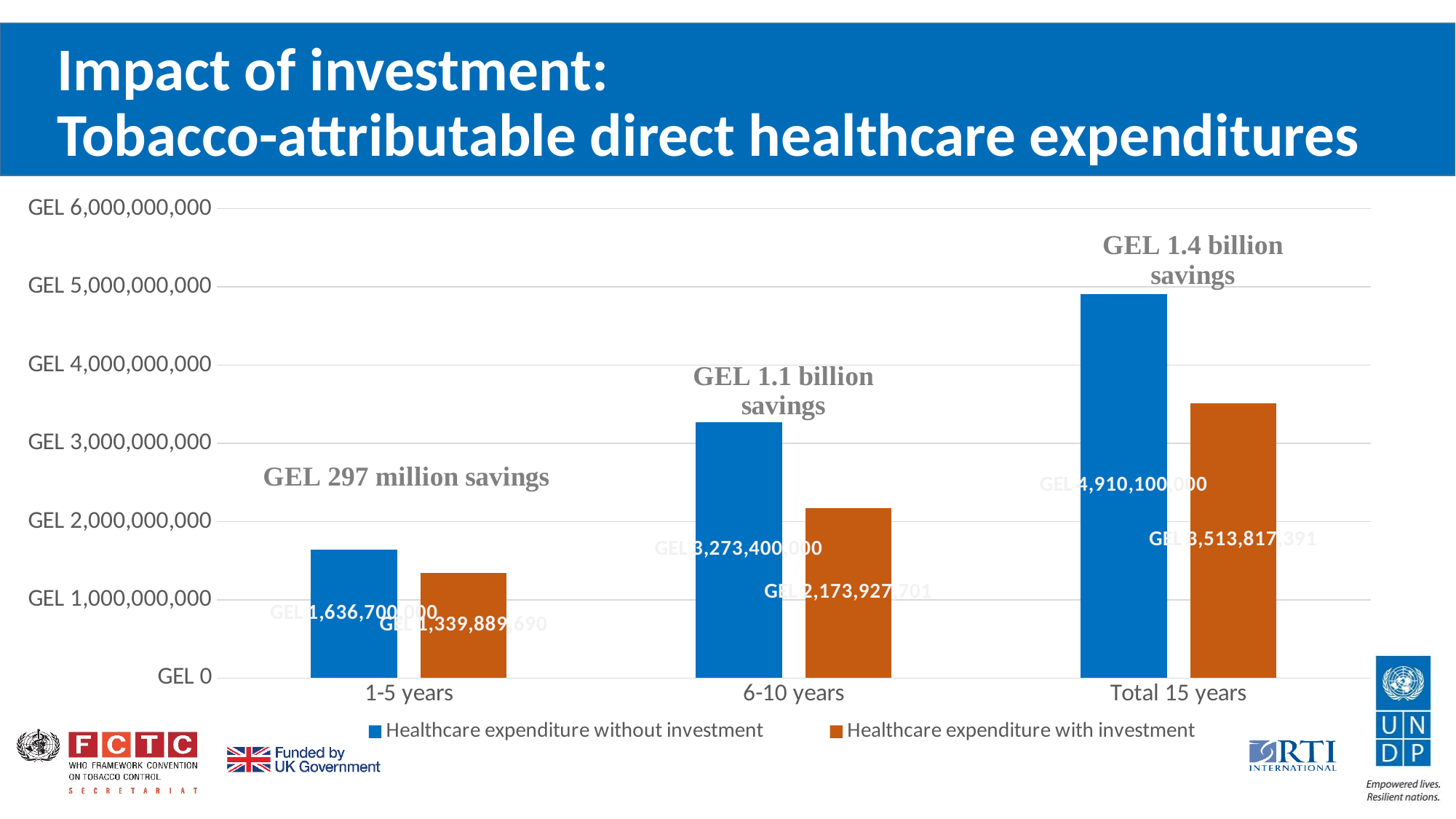
How many categories are shown on the x axis? 3 What is the healthcare expenditure without investment for 1-5 years? GEL 1,636,700,000 What is the healthcare expenditure without investment for Total 15 years? GEL 4,910,100,000 What savings amount is annotated above the 1-5 years bars? GEL 297 million savings What is the healthcare expenditure with investment for 6-10 years? GEL 2,173,927,701 What kind of chart is shown on the slide? Bar chart What is the healthcare expenditure without investment for 6-10 years? GEL 3,273,400,000 Which category has the lowest healthcare expenditure with investment? 1-5 years What savings amount is annotated above the Total 15 years bars? GEL 1.4 billion savings For 6-10 years, which is larger: healthcare expenditure without investment or with investment? Healthcare expenditure without investment Which category has the highest healthcare expenditure without investment? Total 15 years How many series does the legend list? 2